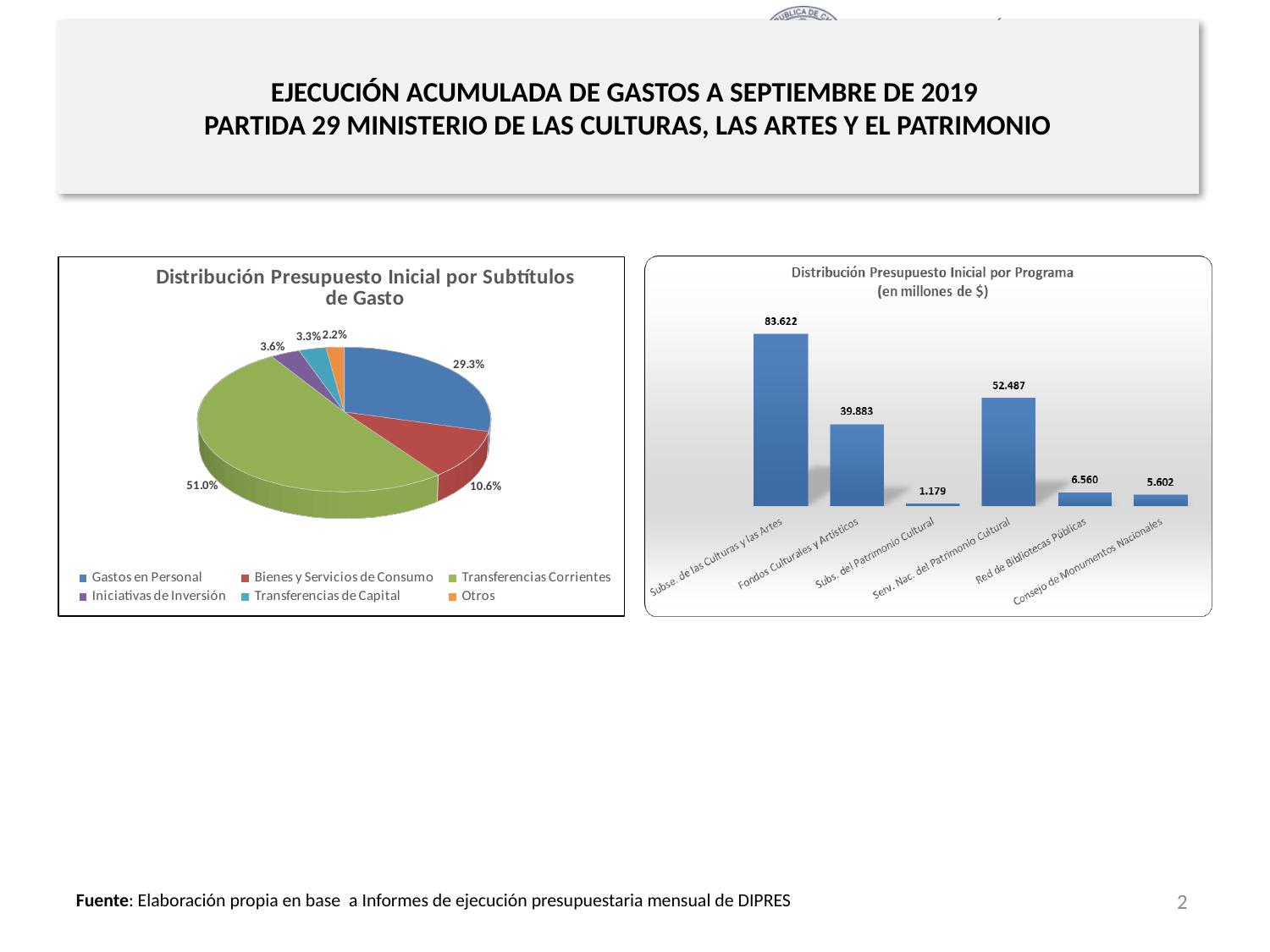
In the 'Distribución Presupuesto Inicial por Subtítulos de Gasto' chart, which category has the smallest share? Otros How many categories does the legend of the 'Distribución Presupuesto Inicial por Subtítulos de Gasto' chart list? 6 In the 'Distribución Presupuesto Inicial por Programa' chart, which program has the lowest value? Subs. del Patrimonio Cultural In the 'Distribución Presupuesto Inicial por Programa' chart, what is the value for Serv. Nac. del Patrimonio Cultural? 52.487 What kind of chart is 'Distribución Presupuesto Inicial por Subtítulos de Gasto'? Pie chart In the 'Distribución Presupuesto Inicial por Programa' chart, which is larger: Red de Bibliotecas Públicas or Consejo de Monumentos Nacionales? Red de Bibliotecas Públicas What kind of chart is 'Distribución Presupuesto Inicial por Programa'? Bar chart In the 'Distribución Presupuesto Inicial por Subtítulos de Gasto' chart, what share does Transferencias Corrientes have? 51.0% In the 'Distribución Presupuesto Inicial por Subtítulos de Gasto' chart, what percentage is shown for Bienes y Servicios de Consumo? 10.6% In the 'Distribución Presupuesto Inicial por Programa' chart, what is the value for Subse. de las Culturas y las Artes? 83.622 In the 'Distribución Presupuesto Inicial por Programa' chart, what is the difference between Subse. de las Culturas y las Artes and Serv. Nac. del Patrimonio Cultural? 31.135 In the 'Distribución Presupuesto Inicial por Subtítulos de Gasto' chart, what percentage is shown for Gastos en Personal? 29.3%